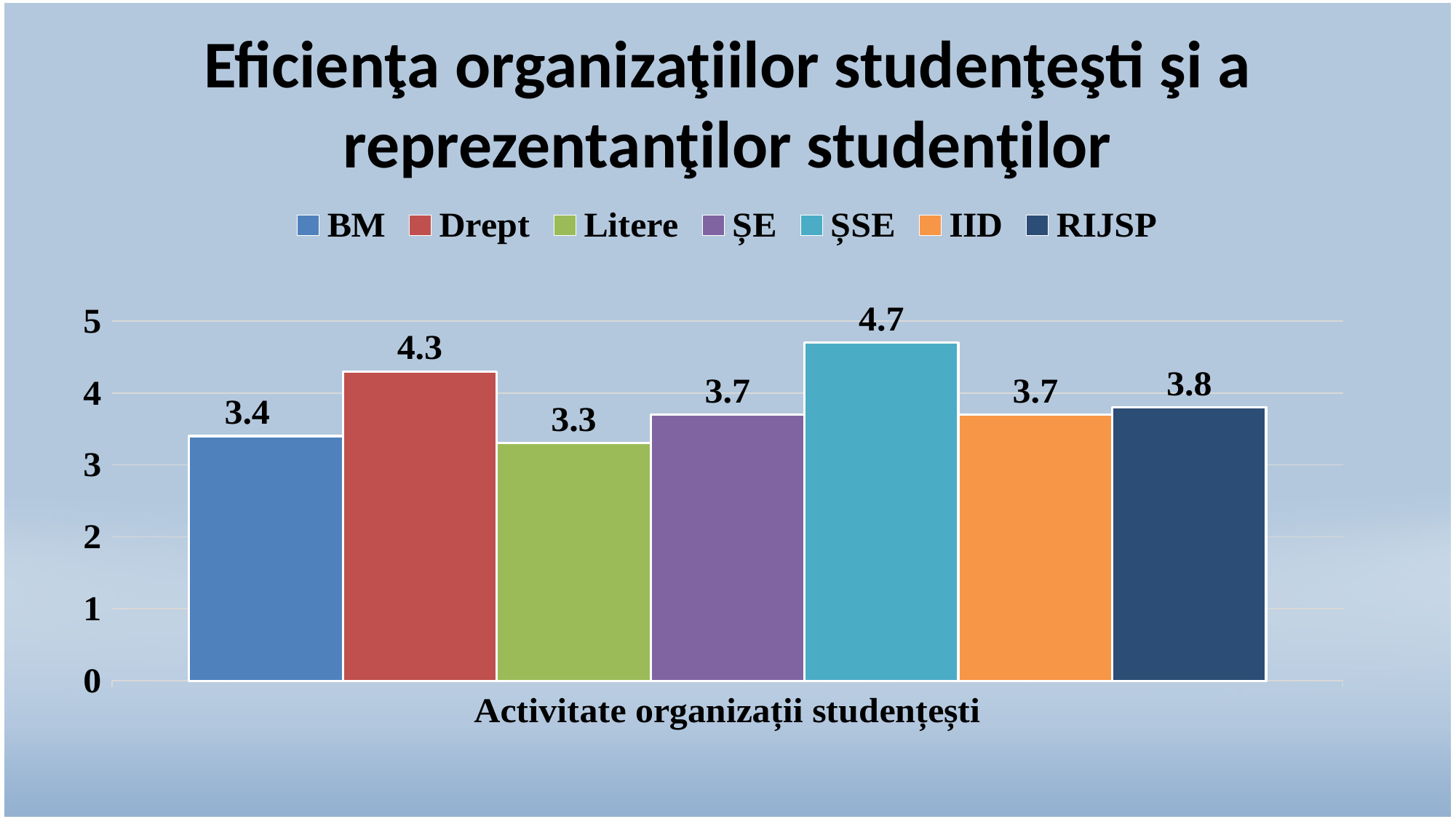
What is the difference between the values for ŞSE and BM? 1.3 Which series has the lowest value? Litere What kind of chart is shown on the slide? bar chart What is the x-axis label of the chart? Activitate organizaţii studenţeşti What colour is the bar for Drept? red What is the value for Litere? 3.3 Is the value for IID greater or less than 4? less What is the value for Drept? 4.3 How many series does the legend list? 7 Which is larger, the value for Drept or the value for RIJSP? Drept What is the value for ŞSE? 4.7 Which series has the highest value? ŞSE